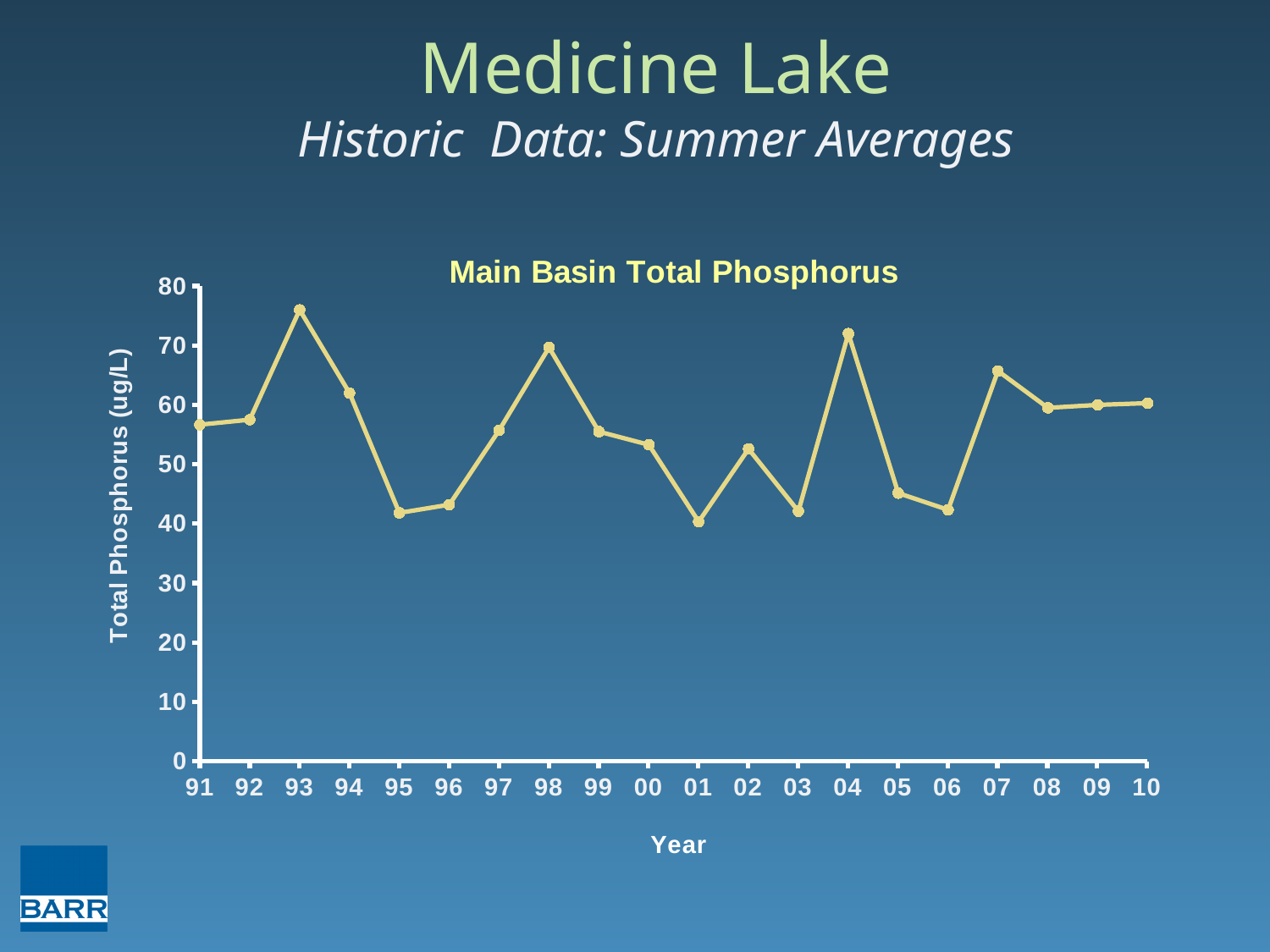
Which year has the highest total phosphorus value? 93 What is the label of the y axis? Total Phosphorus (ug/L) Is the value for 93 greater or less than 70? greater Is the value for 04 greater or less than 70? greater Do the values rise or fall from 93 to 95? fall Which is larger, the value for 94 or the value for 95? 94 Is the value for 01 greater or less than 50? less What kind of chart is shown on the slide? line chart How many years are plotted on the x axis? 20 What is the title of the chart? Main Basin Total Phosphorus Which is larger, the value for 98 or the value for 99? 98